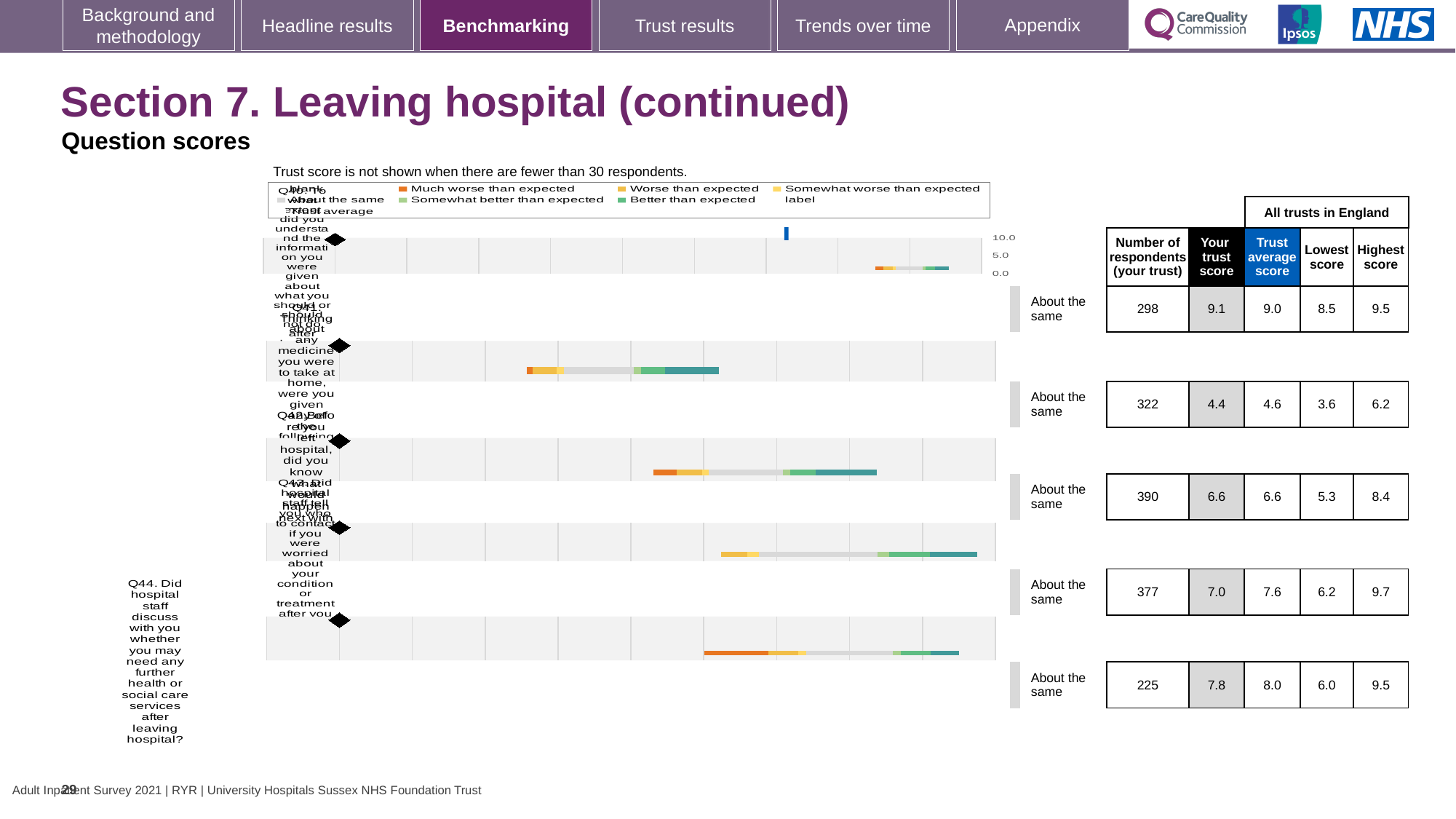
Which row of the chart has the highest trust score? The top row (9.1) Is the trust score for Q44 greater or less than 5.0? greater How many respondents answered Q44 for this trust? 225 How many questions (rows) are plotted in the question scores chart? 5 What is the trust score for Q44 (further health or social care services after leaving hospital)? 7.8 Which question has the fewest respondents for this trust? Q44 (225) What kind of chart is used to show the question scores on this slide? bar chart For Q44, which is larger: your trust score or the trust average score? Trust average score What is the highest score among all trusts in England for Q44? 9.5 What is the difference between the highest score (9.5) and the lowest score (6.0) for Q44? 3.5 What is the trust average score for Q44? 8.0 What benchmark category is shown next to every question in the chart? About the same